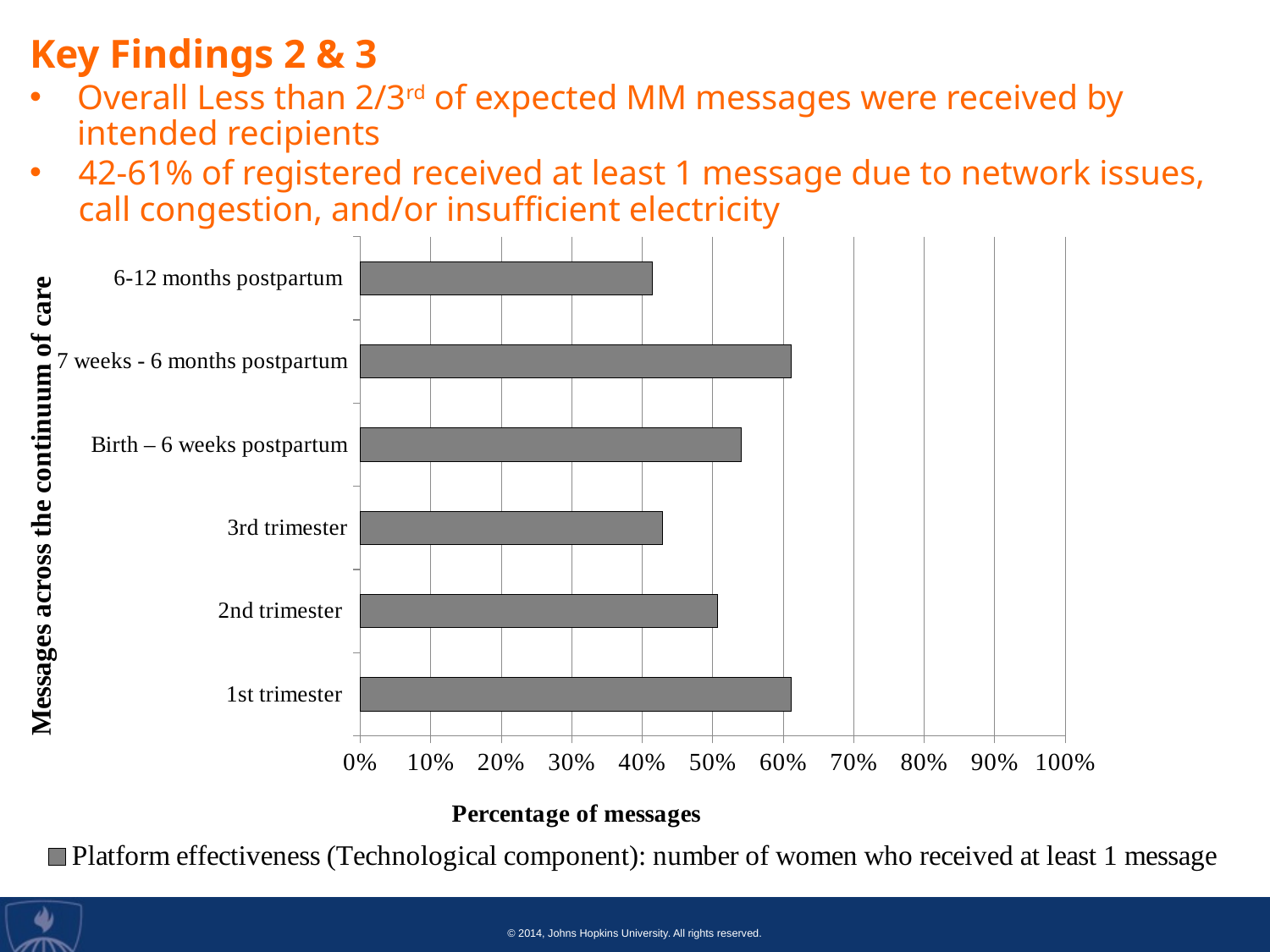
Is the value for 2nd trimester greater or less than 40%? greater What is the y-axis title of the chart? Messages across the continuum of care How many categories are plotted on the chart? 6 Is the value for 7 weeks - 6 months postpartum greater or less than 50%? greater What kind of chart is shown on the slide? bar chart How many series does the chart legend list? 1 Is the value for 3rd trimester greater or less than 50%? less What is the x-axis title of the chart? Percentage of messages Which has a larger value, 1st trimester or 2nd trimester? 1st trimester Which has a larger value, Birth – 6 weeks postpartum or 3rd trimester? Birth – 6 weeks postpartum